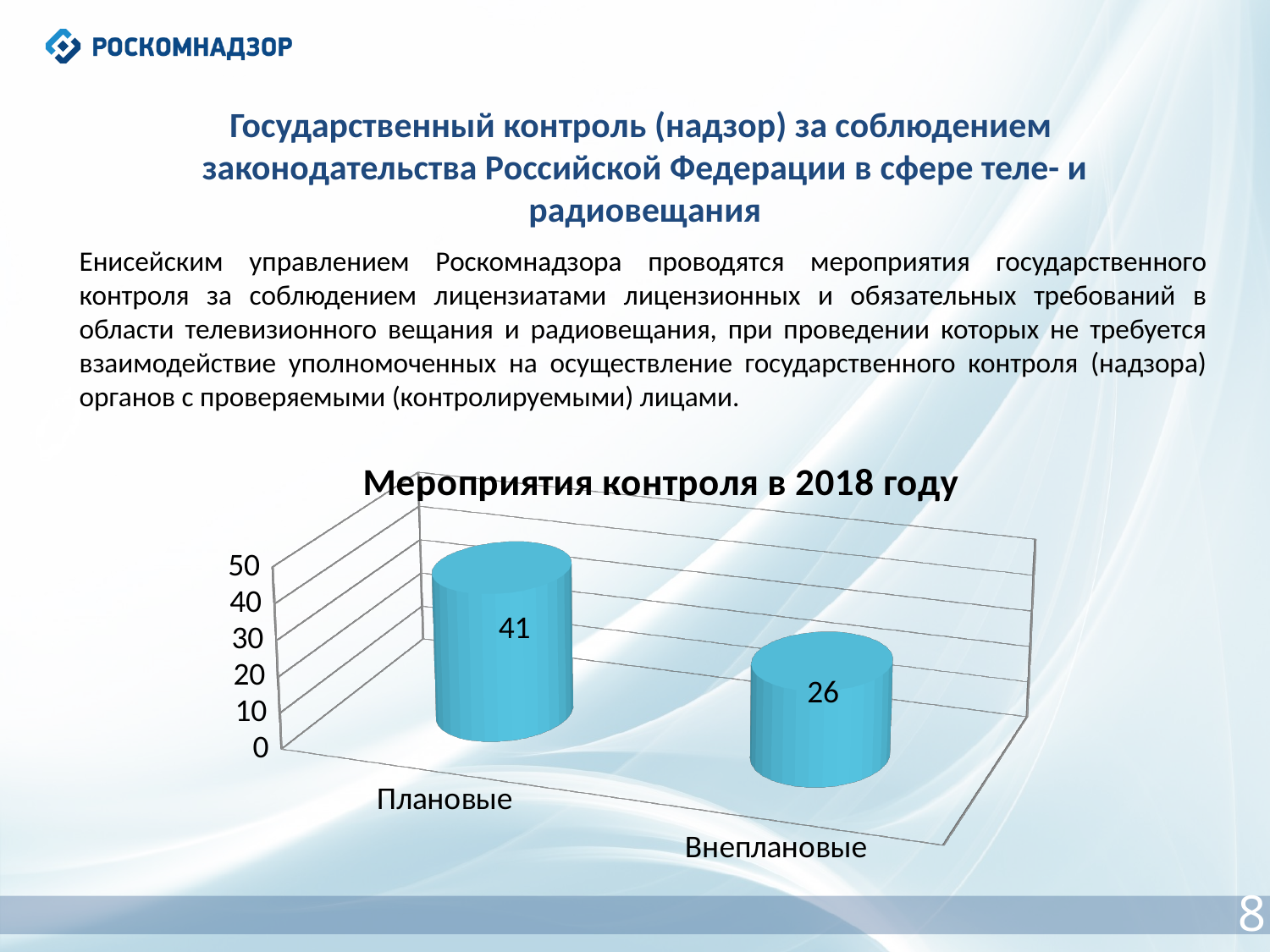
What is the value for Внеплановые in the chart 'Мероприятия контроля в 2018 году'? 26 What is the difference between the values for Плановые and Внеплановые? 15 What is the total of the two values shown in the chart? 67 What is the title of the chart on the slide? Мероприятия контроля в 2018 году Which category has the lowest value in the chart? Внеплановые Is the value for Внеплановые greater or less than 30? less Is the value for Плановые greater or less than 40? greater Which is larger, the value for Плановые or the value for Внеплановые? Плановые What kind of chart is shown on the slide? bar chart How many categories are shown in the chart? 2 Which category has the highest value in the chart? Плановые What is the value for Плановые in the chart 'Мероприятия контроля в 2018 году'? 41